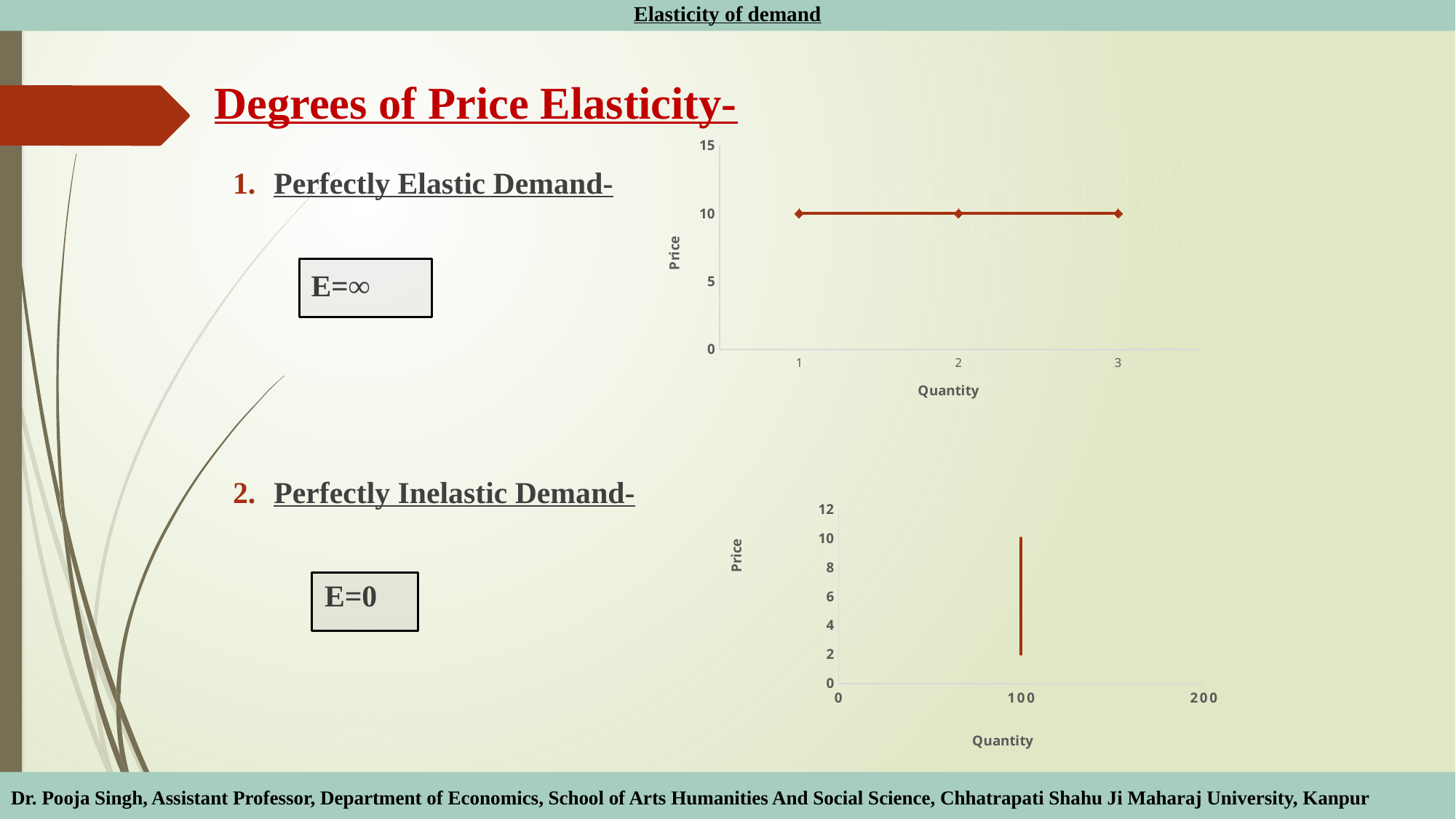
In the top chart (Perfectly Elastic Demand), how many data points are plotted? 3 In the top chart (Perfectly Elastic Demand), what is the price at quantity 3? 10 In the bottom chart (Perfectly Inelastic Demand), is the quantity of the line greater or less than 200? less In the top chart (Perfectly Elastic Demand), what is the price at quantity 1? 10 In the top chart (Perfectly Elastic Demand), what is the highest value shown on the vertical axis? 15 In the top chart (Perfectly Elastic Demand), do the price values rise, fall, or stay flat as quantity increases? stay flat In the top chart (Perfectly Elastic Demand), what is the label of the vertical axis? Price In the top chart (Perfectly Elastic Demand), is the price at quantity 2 greater or less than 5? greater In the top chart (Perfectly Elastic Demand), what kind of chart is shown? line chart In the bottom chart (Perfectly Inelastic Demand), what is the highest value shown on the vertical axis? 12 In the bottom chart (Perfectly Inelastic Demand), at what quantity is the vertical line drawn? 100 In the bottom chart (Perfectly Inelastic Demand), does the quantity change as price rises from 2 to 10? No, it stays at 100